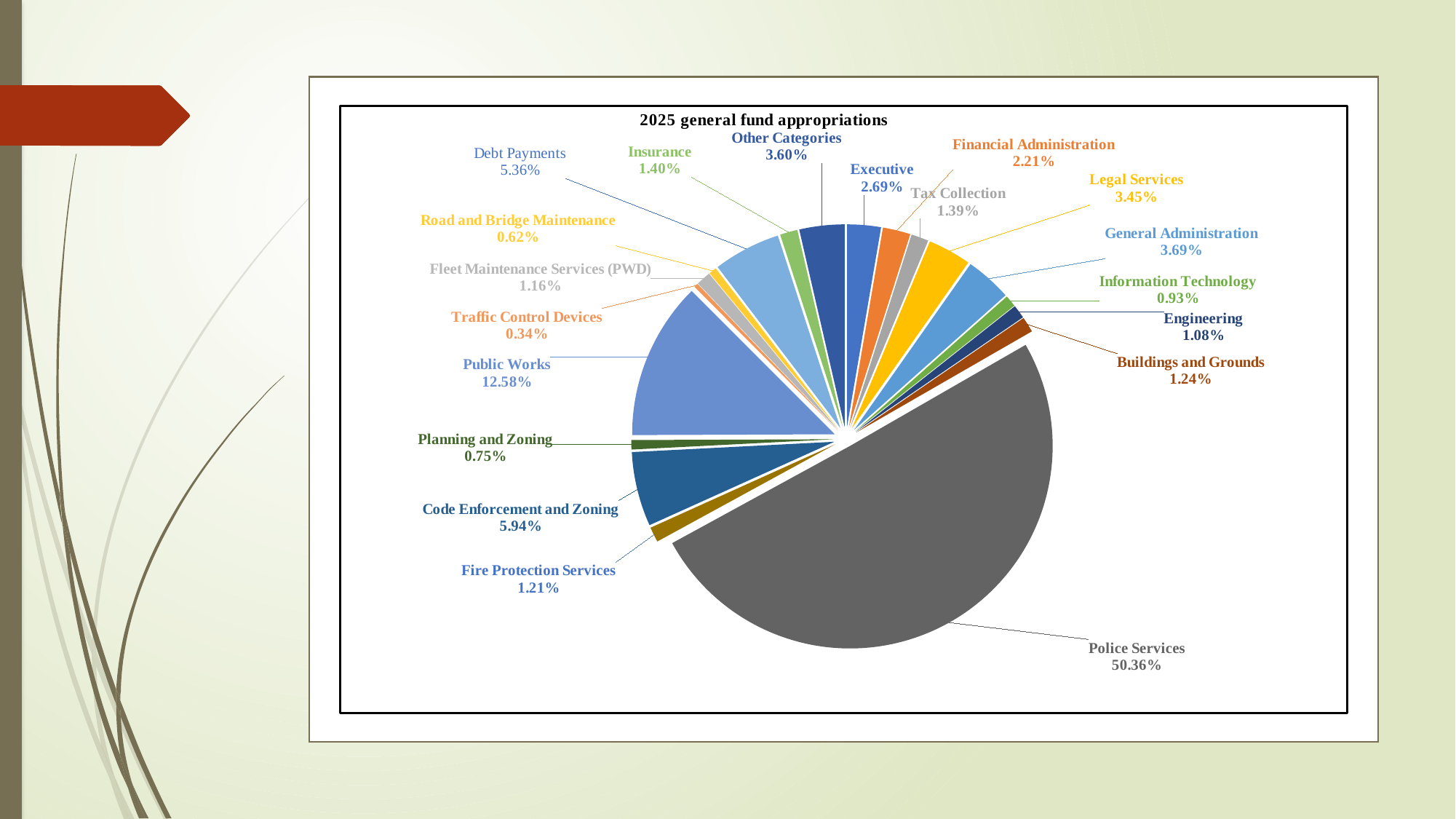
How many categories are shown in the pie chart? 19 What kind of chart is shown on the slide? pie chart What is the difference in percentage points between Police Services and Public Works? 37.78 What is the title of the chart? 2025 general fund appropriations What percentage is shown for Code Enforcement and Zoning? 5.94% Which category has the smallest share of the pie? Traffic Control Devices Which is larger, the share for Debt Payments or the share for Code Enforcement and Zoning? Code Enforcement and Zoning What share of the 2025 general fund appropriations goes to Police Services? 50.36% Which category has the largest share of the pie? Police Services What percentage is shown for Traffic Control Devices? 0.34% What is the difference in percentage points between Public Works and Code Enforcement and Zoning? 6.64 What percentage is shown for Public Works? 12.58%